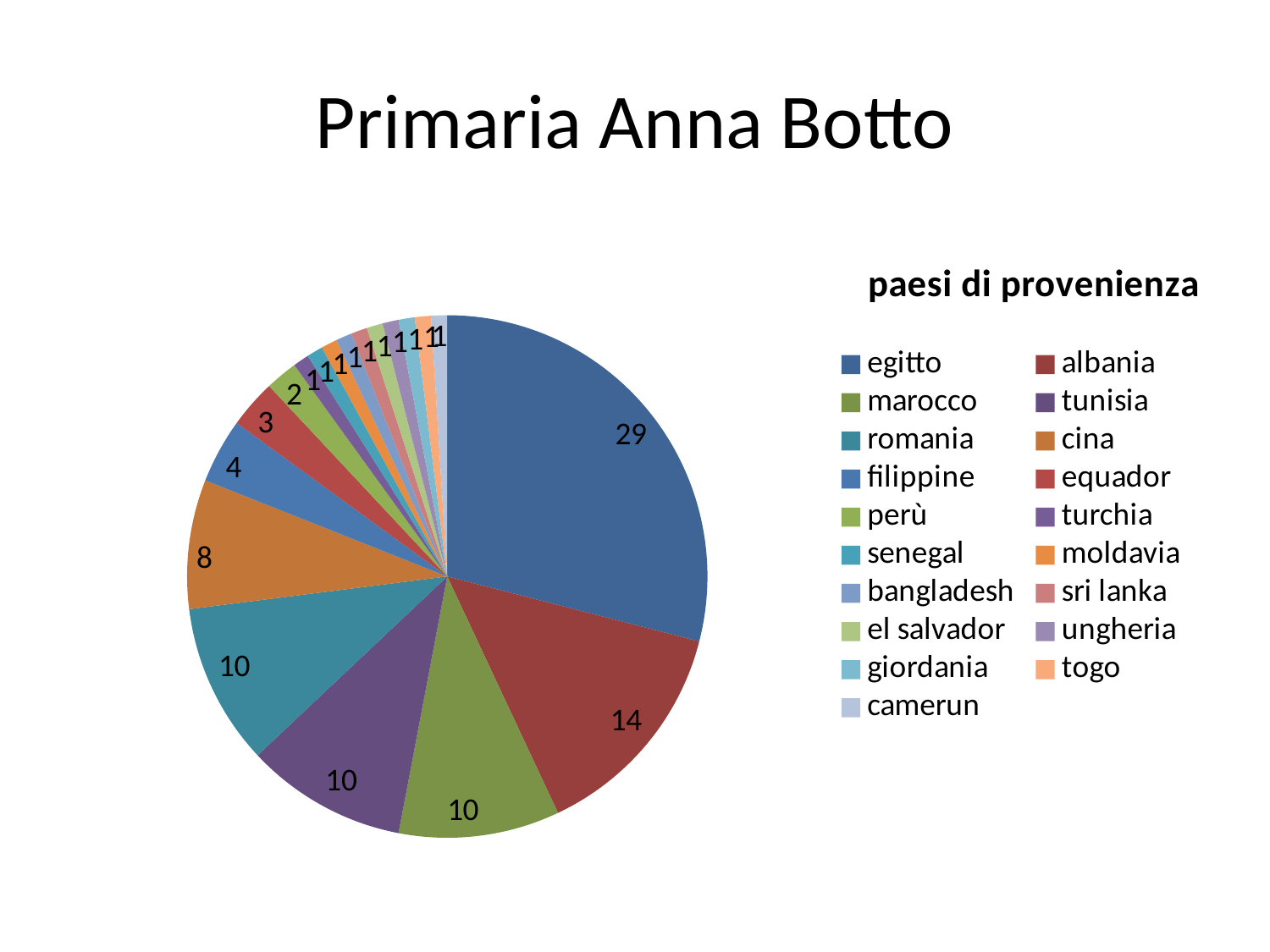
What value is shown for cina in the pie chart? 8 What value is shown for perù in the pie chart? 2 How many countries are listed in the legend of the pie chart? 19 What value is shown for albania in the pie chart? 14 What value is shown for equador in the pie chart? 3 What kind of chart is shown on the slide? pie chart Which country has the largest slice in the pie chart? egitto Which has a larger value, cina or filippine? cina What is the title of the chart's legend? paesi di provenienza What is the difference between the values for egitto and albania? 15 What value is shown for filippine in the pie chart? 4 What value is shown for egitto in the pie chart? 29